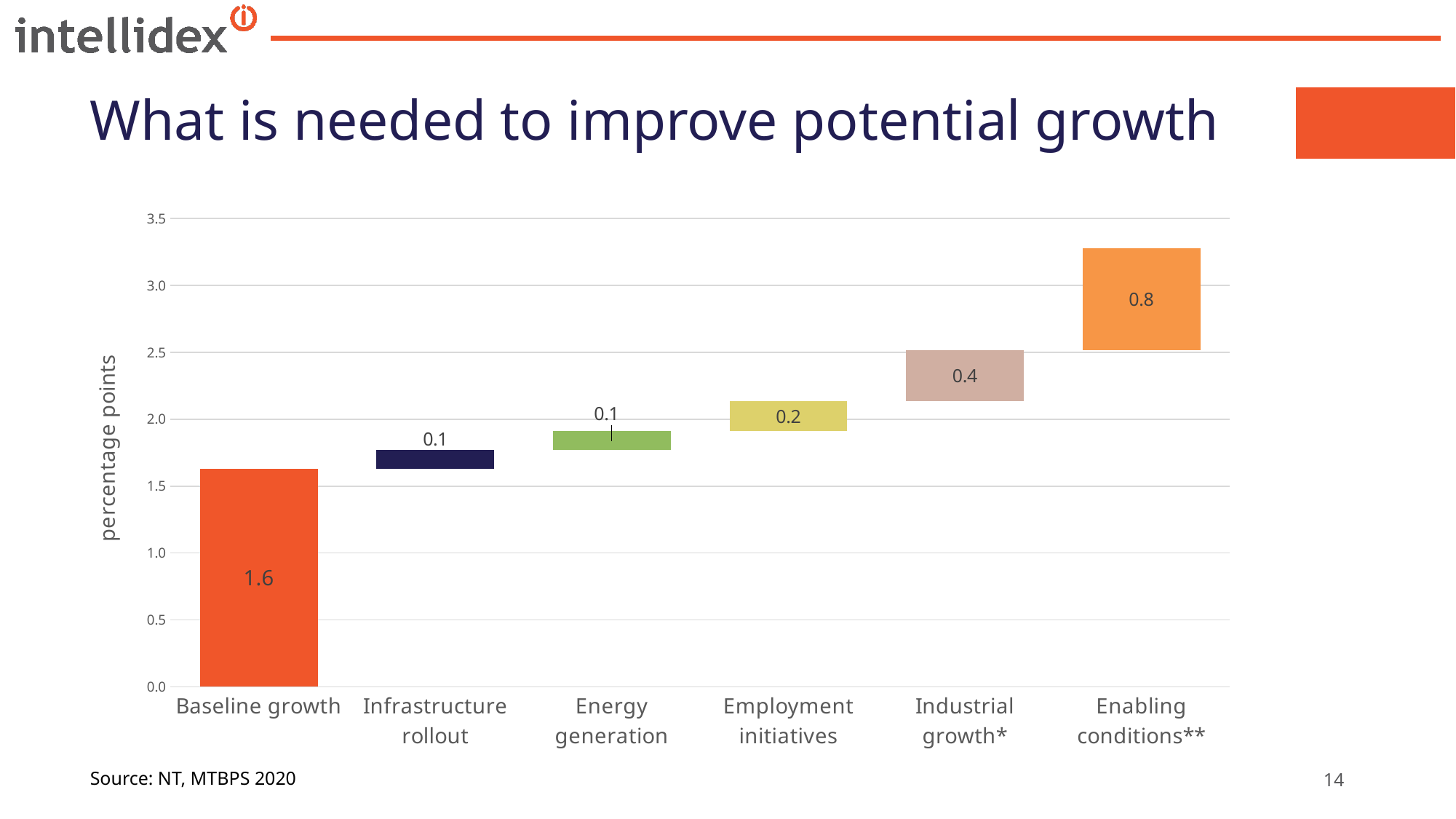
What is the value for Baseline growth? 1.6 Which category has the highest value? Baseline growth Which is larger, the value for Industrial growth* or the value for Employment initiatives? Industrial growth* What is the sum of all the labelled values in the chart? 3.2 What is the difference between the values for Enabling conditions** and Industrial growth*? 0.4 What is the value for Employment initiatives? 0.2 What is the label on the vertical axis? percentage points How many categories are shown on the x axis? 6 What is the difference between the values for Baseline growth and Enabling conditions**? 0.8 What is the value for Infrastructure rollout? 0.1 What is the value for Enabling conditions**? 0.8 What is the value for Industrial growth*? 0.4